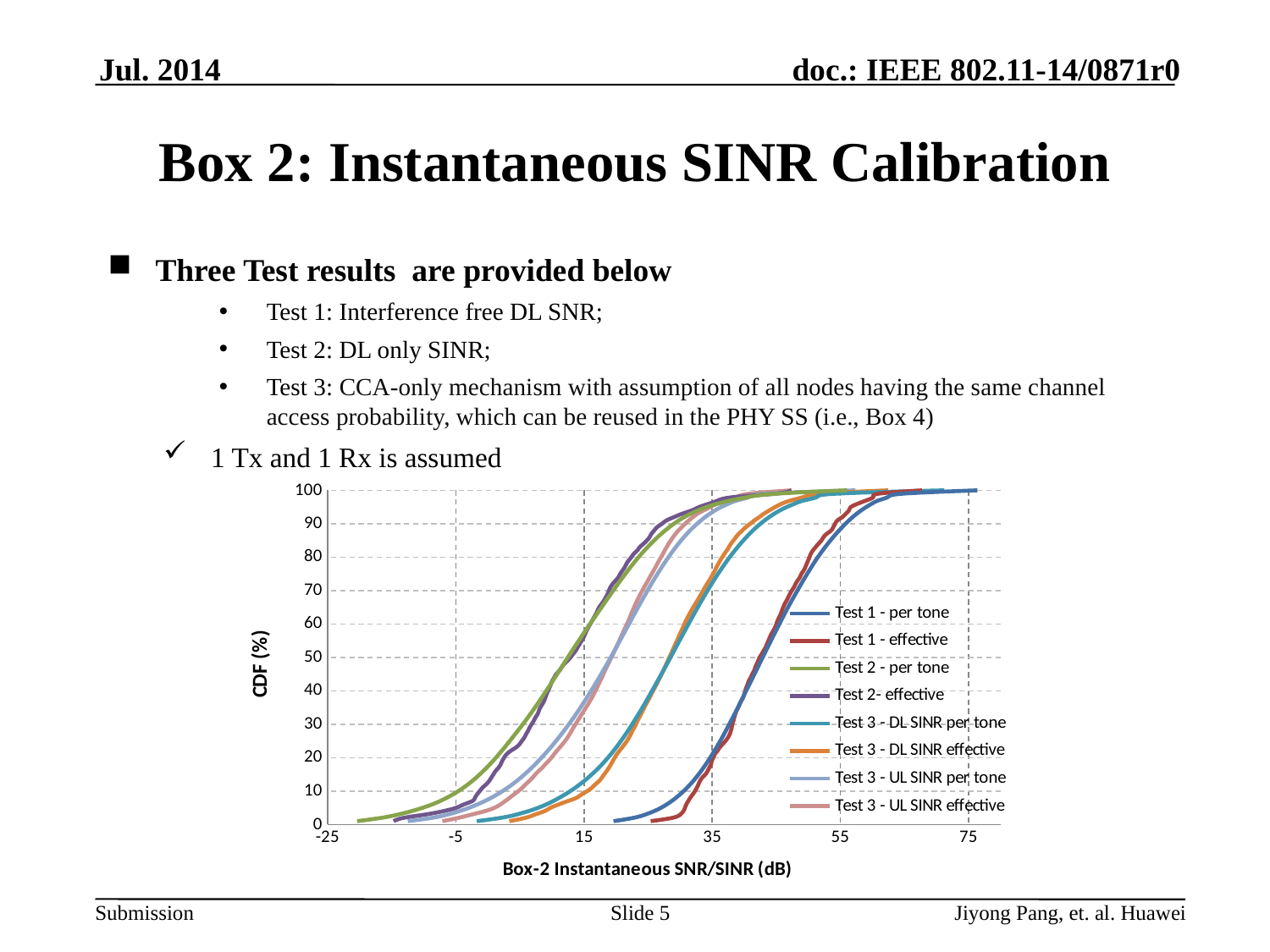
What kind of chart is shown on the slide? Line chart What is the label of the y axis of the chart? CDF (%) What is the label of the x axis of the chart? Box-2 Instantaneous SNR/SINR (dB) At 35 dB, which series has the higher CDF value: Test 3 - DL SINR effective or Test 1 - effective? Test 3 - DL SINR effective Is the CDF value for Test 2- effective at 35 dB greater or less than 90? greater Do the CDF curves rise or fall as the SNR/SINR increases along the x axis? Rise Is the CDF value for Test 3 - UL SINR per tone at 15 dB greater or less than 50? less Is the CDF value for Test 2 - per tone at -5 dB greater or less than 20? less How many series does the chart legend list? 8 At 15 dB, which series has the higher CDF value: Test 2 - per tone or Test 1 - per tone? Test 2 - per tone